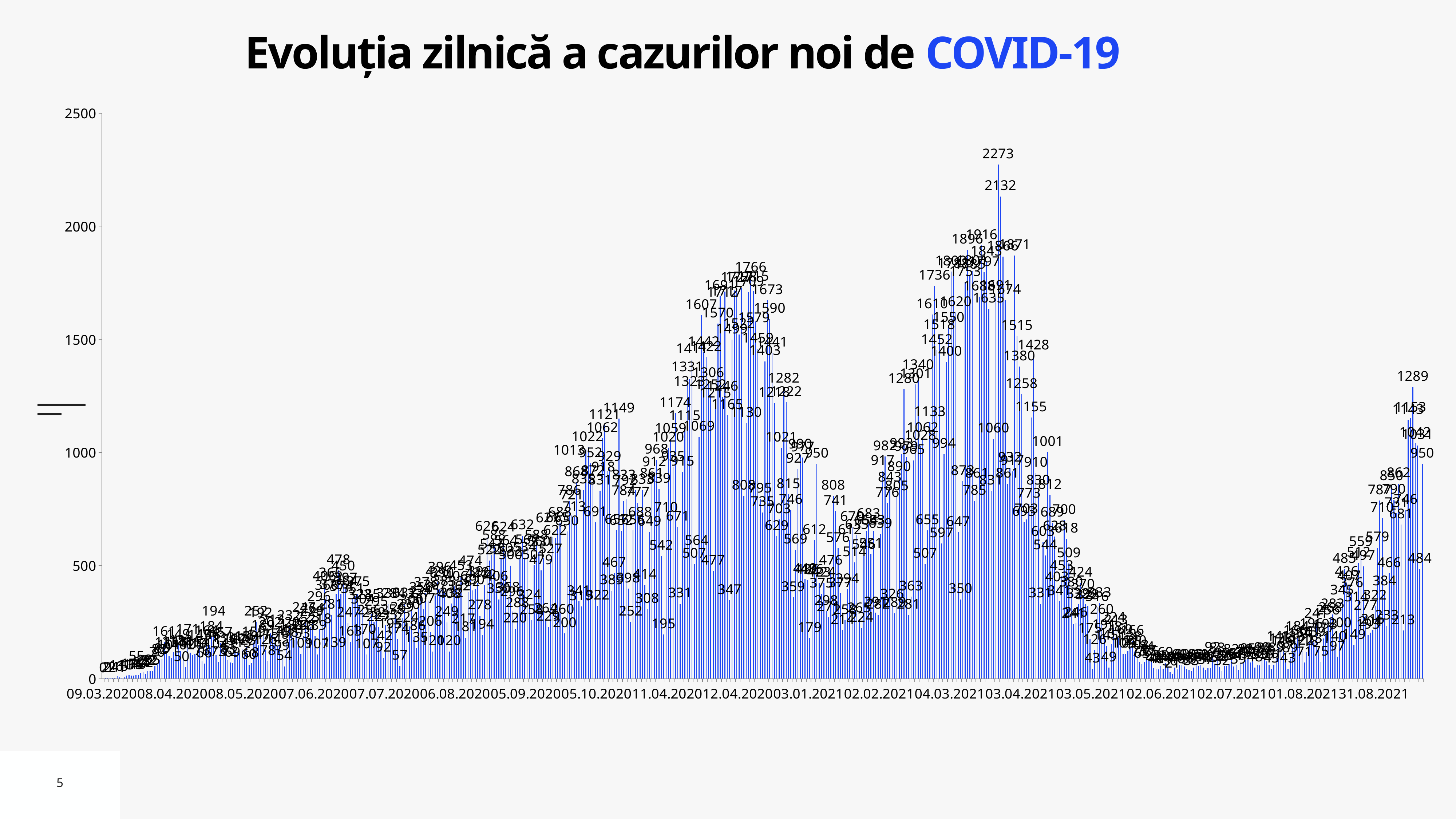
What is the highest daily value labelled on the chart? 2273 Which is larger: the peak of 2273 around 03.04.2021 or the peak of 1766 around 12.04.2020? 2273 What is the highest value labelled in the final rise after 01.08.2021? 1289 Do the values rise or fall between 03.04.2021 and 03.05.2021? fall Do the values rise or fall between 02.06.2021 and 31.08.2021? rise What is the maximum value shown on the vertical axis? 2500 What kind of chart is shown on the slide? bar chart Is the highest bar on the chart greater or less than 2000? greater What is the title of the chart? Evoluția zilnică a cazurilor noi de COVID-19 What is the second-highest value labelled on the chart, next to the 2273 peak? 2132 What is the difference between the two highest labelled values, 2273 and 2132? 141 What is the highest value labelled in the wave around 12.04.2020? 1766